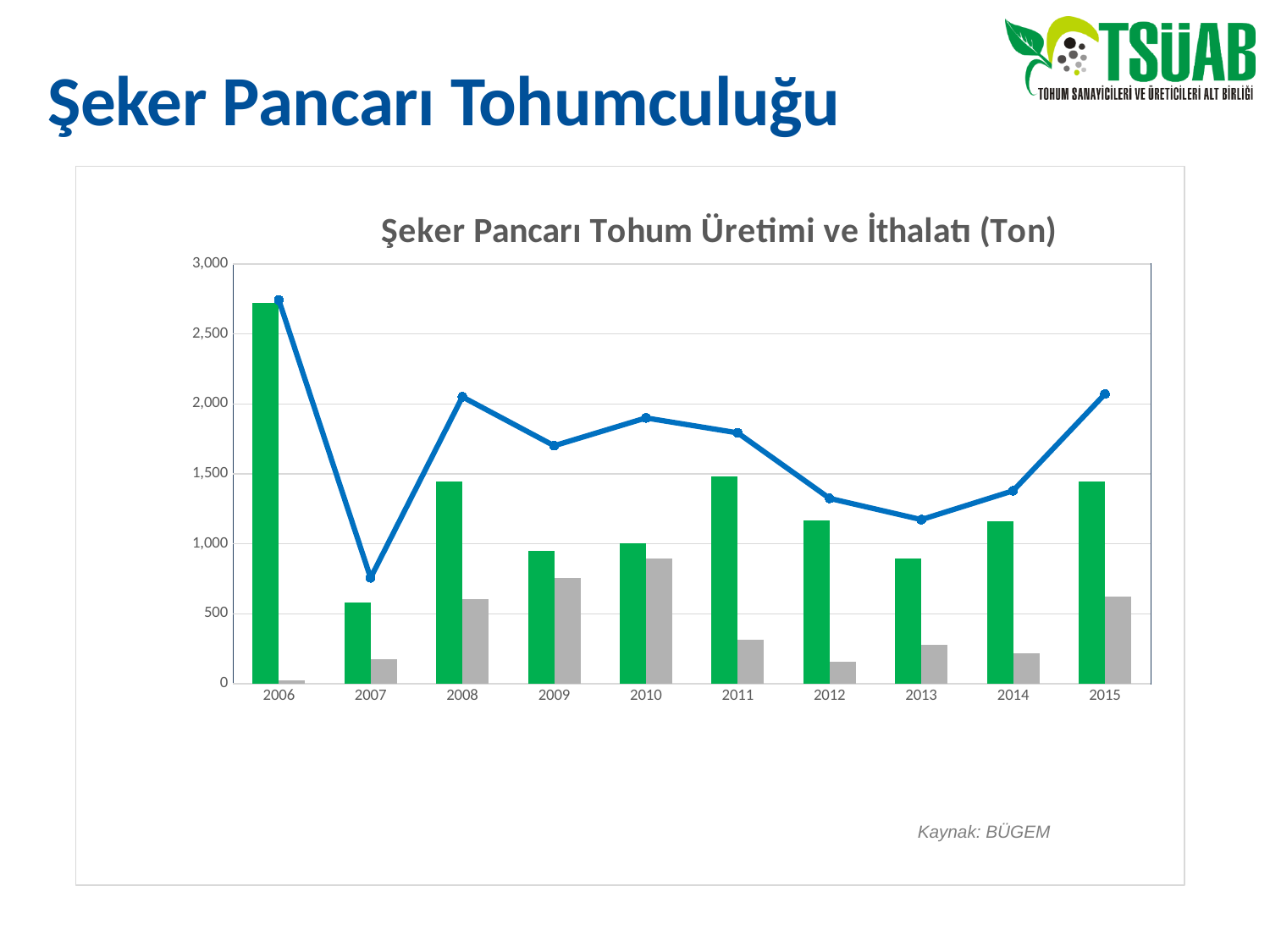
Is the blue line value for 2015 greater or less than 1,500? greater Which is larger, the green bar for 2008 or the green bar for 2009? 2008 In which year is the gray bar the lowest? 2006 In which year does the blue line reach its lowest point? 2007 In which year is the gray bar the highest? 2010 What kind of chart is shown on the slide? A combined bar and line chart Is the green bar for 2007 greater or less than 1,000? less In which year is the green bar the highest? 2006 What source is cited below the chart? Kaynak: BÜGEM What is the title of the chart? Şeker Pancarı Tohum Üretimi ve İthalatı (Ton) How many years are shown on the x axis of the chart? 10 Is the green bar for 2006 greater or less than 2,500? greater